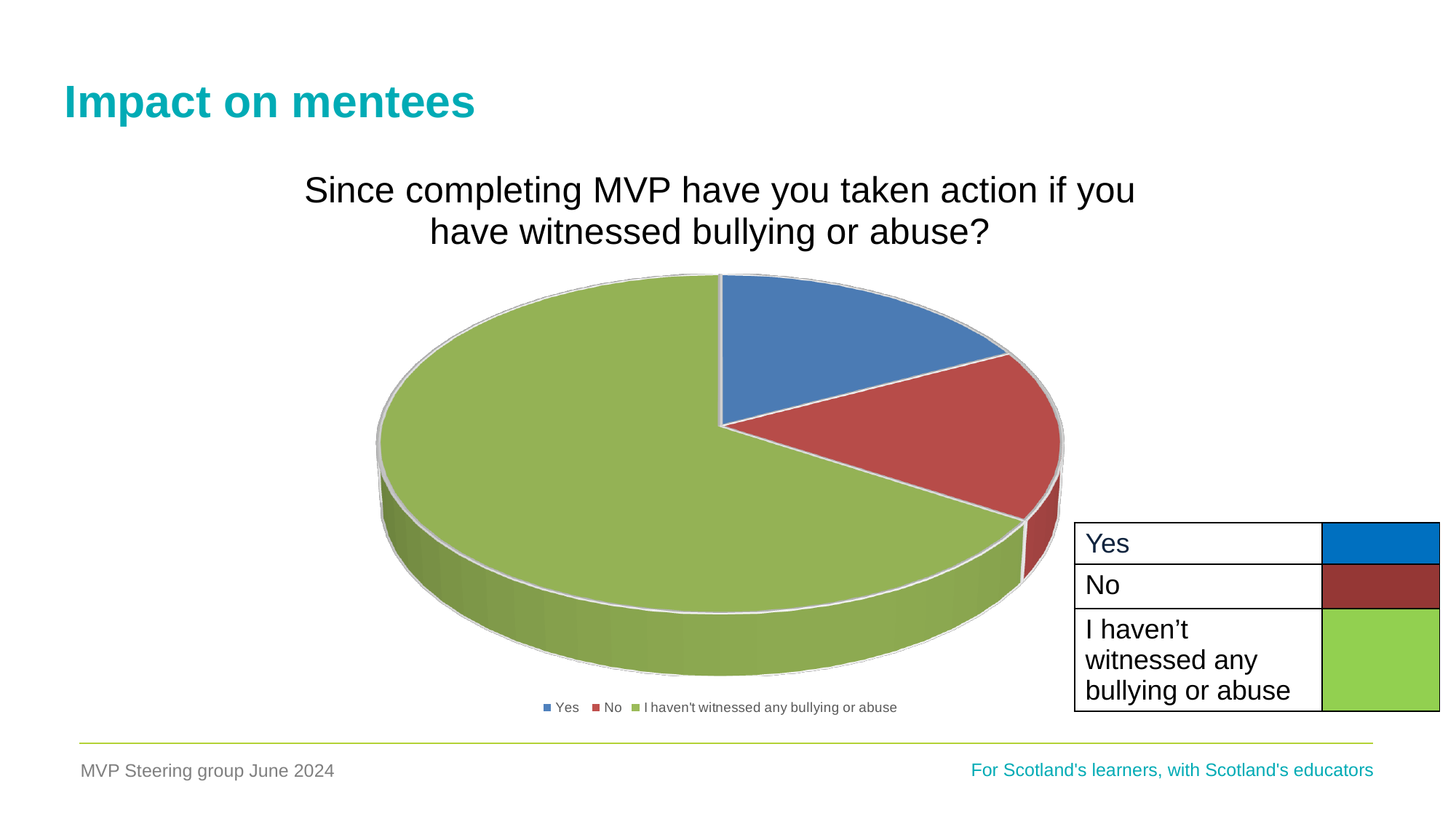
Which response category has the largest slice of the pie? I haven't witnessed any bullying or abuse Which slice is larger: 'Yes' or 'I haven't witnessed any bullying or abuse'? I haven't witnessed any bullying or abuse How many slices does the pie chart have? 3 Which slice is larger: 'No' or 'I haven't witnessed any bullying or abuse'? I haven't witnessed any bullying or abuse What colour represents the 'No' response in the pie chart? Red What kind of chart is shown on the slide? Pie chart How many entries does the chart legend list? 3 What is the title of the chart? Since completing MVP have you taken action if you have witnessed bullying or abuse?